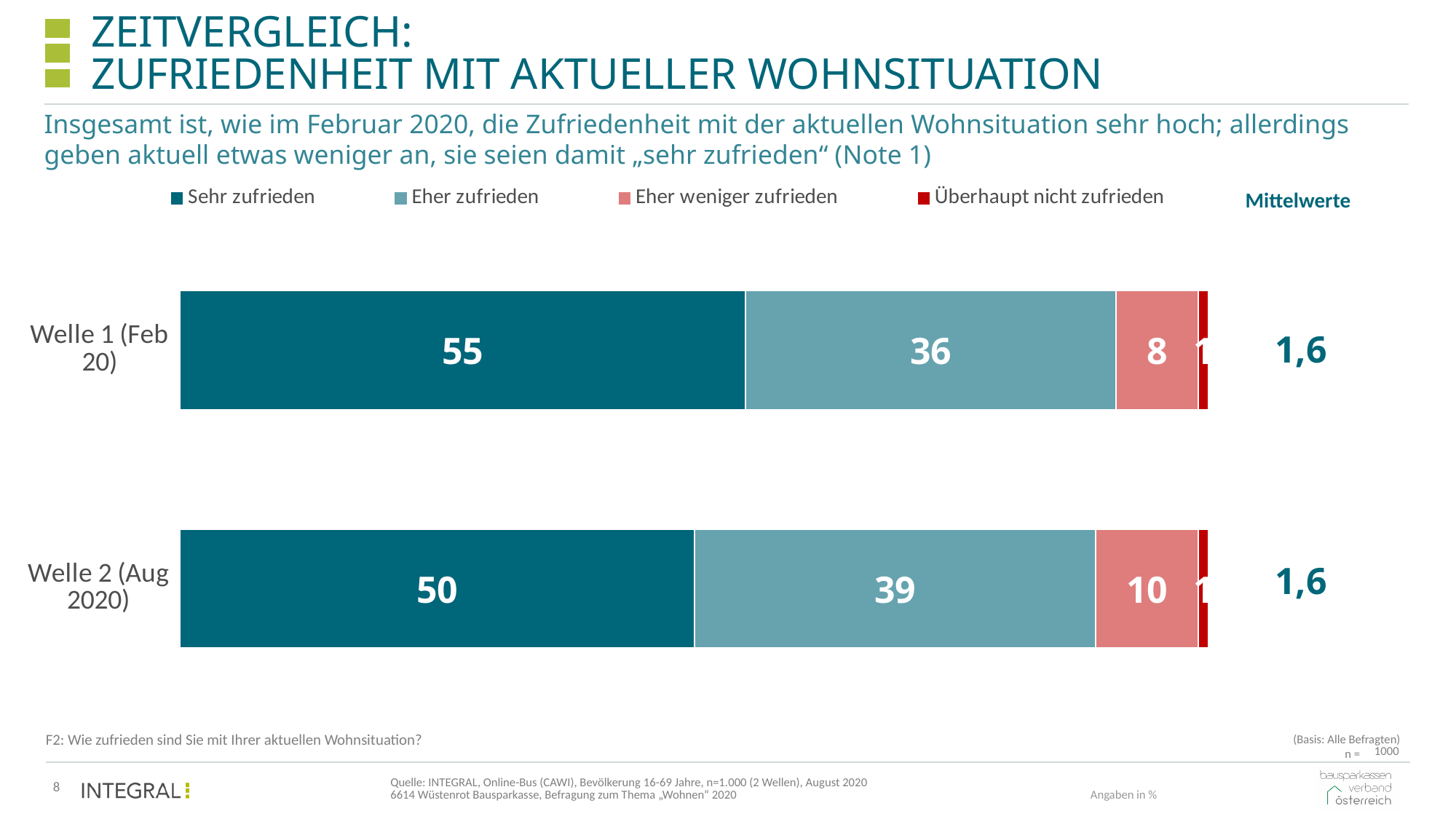
What is the value for "Überhaupt nicht zufrieden" in Welle 1 (Feb 20)? 1 What is the difference between the "Sehr zufrieden" values of Welle 1 (Feb 20) and Welle 2 (Aug 2020)? 5 What is the value for "Eher zufrieden" in Welle 2 (Aug 2020)? 39 How many series does the legend list? 4 How many categories (waves) are shown in the chart? 2 What is the value for "Sehr zufrieden" in Welle 1 (Feb 20)? 55 Which legend entry is shown in dark red? Überhaupt nicht zufrieden What is the Mittelwert shown for Welle 2 (Aug 2020)? 1,6 What is the difference between the "Eher weniger zufrieden" values of Welle 2 (Aug 2020) and Welle 1 (Feb 20)? 2 Which wave has the higher value for "Sehr zufrieden"? Welle 1 (Feb 20) What kind of chart is shown on the slide? Stacked bar chart What is the value for "Eher weniger zufrieden" in Welle 2 (Aug 2020)? 10